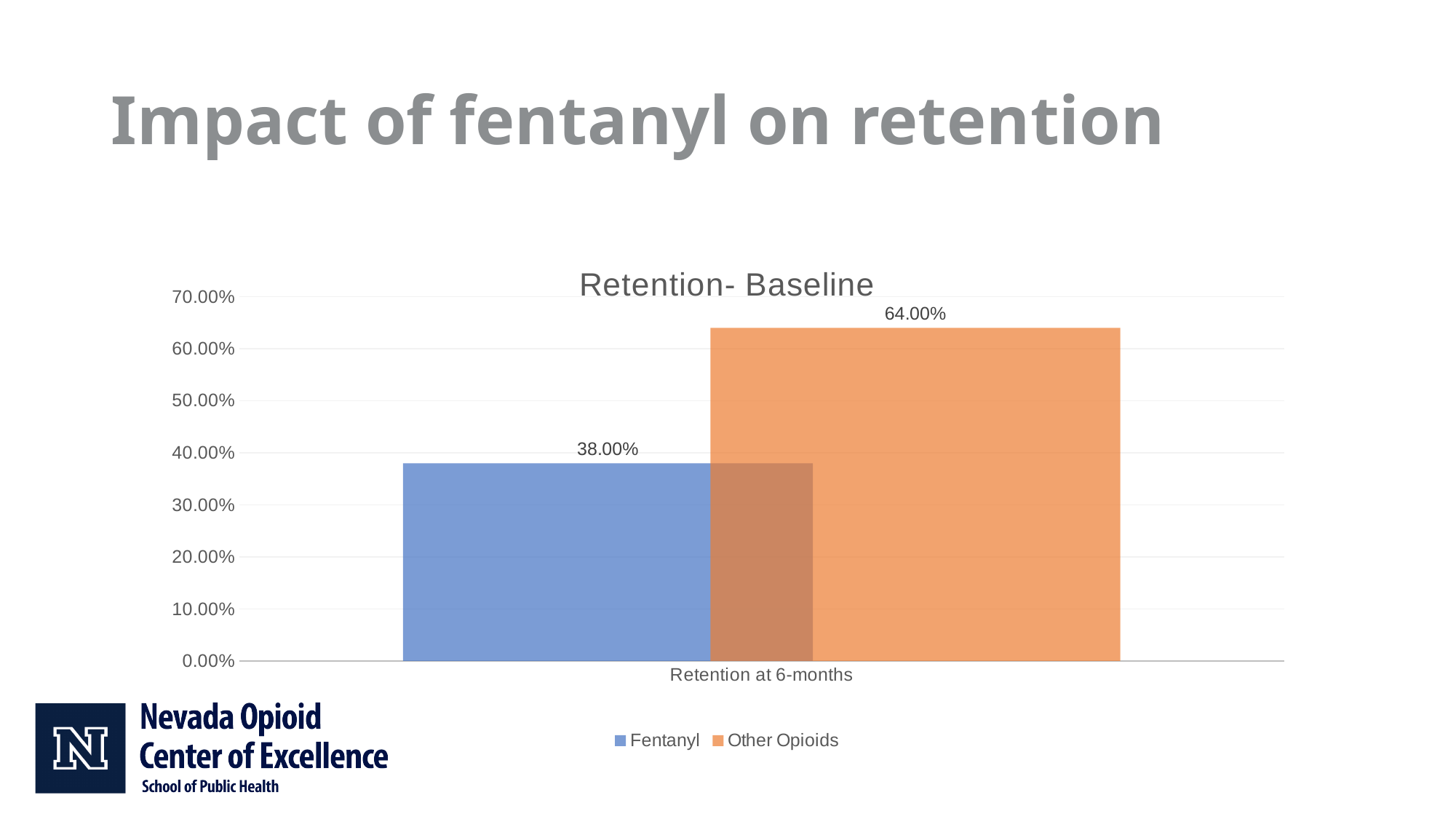
How many categories are shown on the x axis? 1 Is the retention value for Other Opioids greater or less than 60.00%? greater What kind of chart is shown on the slide? Bar chart Which series has the lower retention at 6-months? Fentanyl Is the retention value for Fentanyl greater or less than 40.00%? less What is the retention at 6-months value for Other Opioids? 64.00% How many series does the legend list? 2 What is the difference between the Other Opioids and Fentanyl retention values? 26.00% What is the title of the chart? Retention- Baseline Which series has the higher retention at 6-months? Other Opioids What colour is the Other Opioids bar? Orange What is the retention at 6-months value for Fentanyl? 38.00%